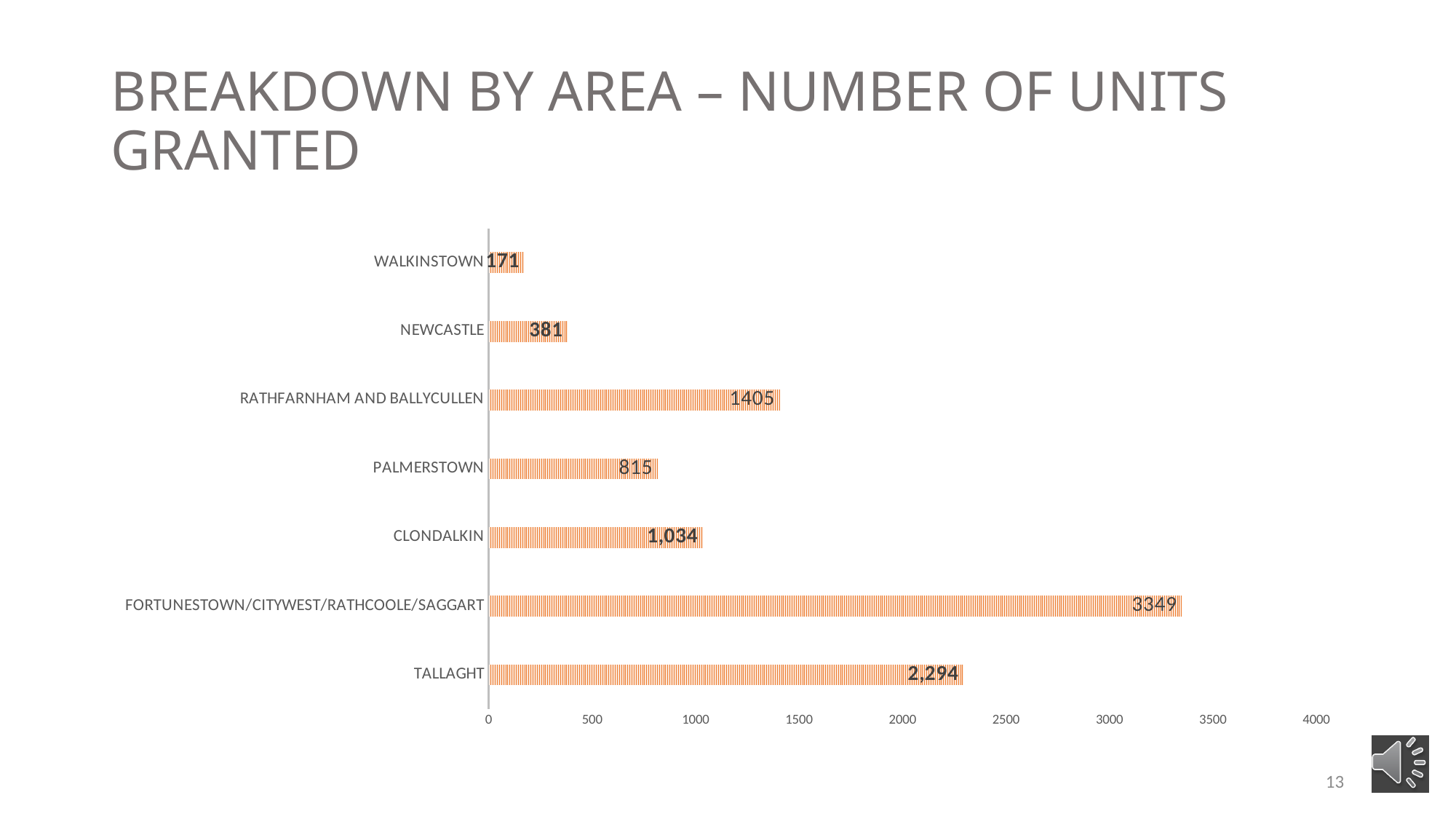
What is the number of units granted for Rathfarnham and Ballycullen? 1405 Which has more units granted, Rathfarnham and Ballycullen or Clondalkin? Rathfarnham and Ballycullen What kind of chart is shown on the slide? Bar chart What is the title of the slide? Breakdown by Area – Number of Units Granted How many areas are shown in the chart? 7 What is the difference in units granted between Clondalkin and Palmerstown? 219 What is the number of units granted for Newcastle? 381 What is the number of units granted for Tallaght? 2,294 Which area has the highest number of units granted? Fortunestown/Citywest/Rathcoole/Saggart Which area has the lowest number of units granted? Walkinstown What is the difference in units granted between Fortunestown/Citywest/Rathcoole/Saggart and Tallaght? 1055 What is the number of units granted for Palmerstown? 815